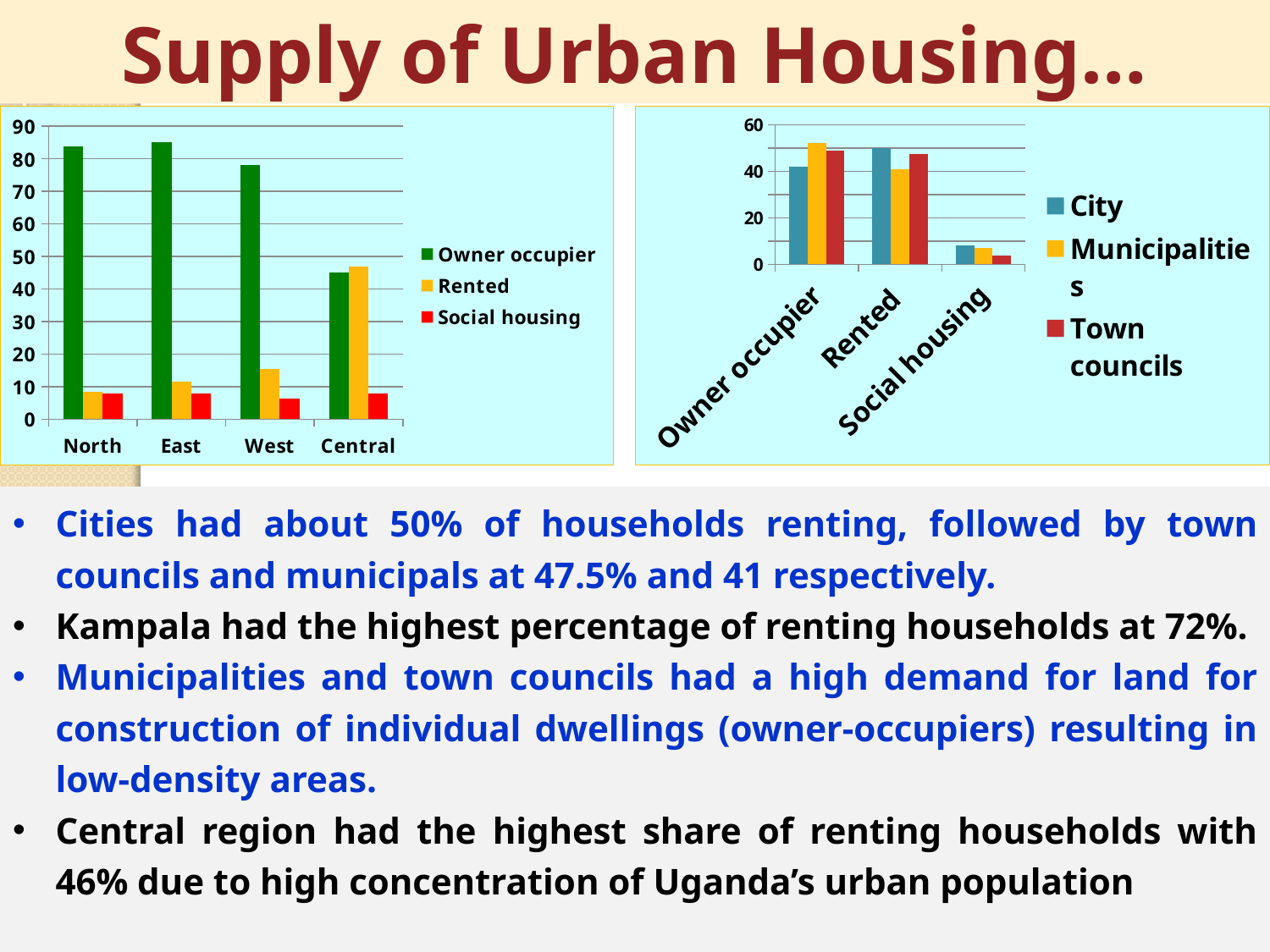
On the right chart, how many series does the legend list? 3 On the right chart, which category has the lowest values across all three series? Social housing On the left chart, which region has the lowest Owner occupier value? Central What kind of chart is the left chart? bar chart On the left chart, which region has the highest Rented value? Central On the right chart, which series has the highest Rented value? City On the left chart, how many series does the legend list? 3 On the left chart, which is larger for West: Rented or Social housing? Rented On the left chart, how many regions are shown on the x axis? 4 On the left chart, is the Owner occupier value for West greater or less than 70? greater On the left chart, is the Rented value for North greater or less than 20? less